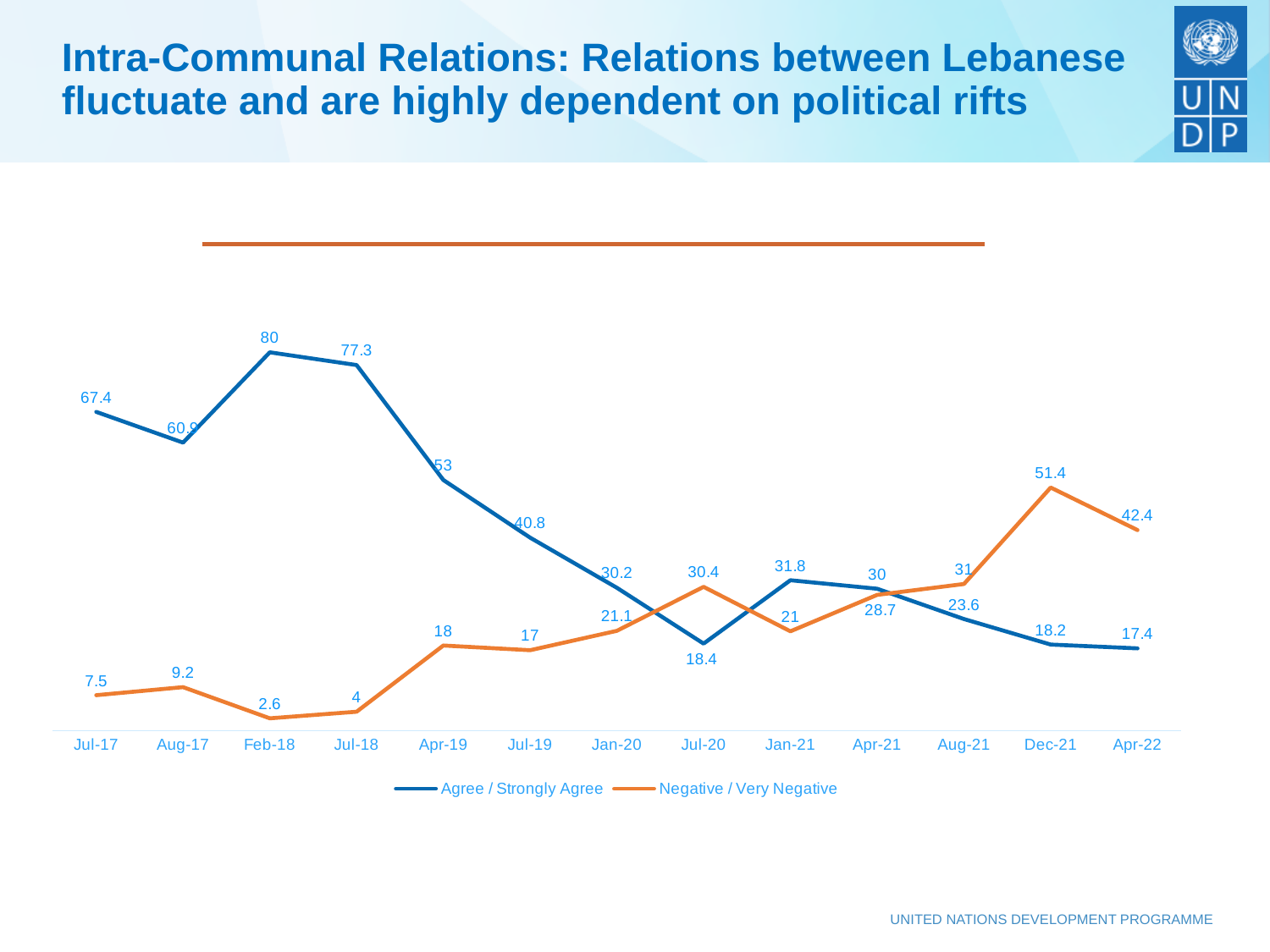
How many series does the legend list? 2 What is the value for Agree / Strongly Agree in Apr-22? 17.4 What colour is the line for Negative / Very Negative? orange In which period is the Agree / Strongly Agree series at its highest? Feb-18 Does the Negative / Very Negative series generally rise or fall from Jul-17 to Apr-22? rise How many time points are shown on the x axis? 13 What is the value for Agree / Strongly Agree in Feb-18? 80 What kind of chart is shown on the slide? line chart What is the value for Negative / Very Negative in Dec-21? 51.4 What is the difference between the Agree / Strongly Agree value in Jul-18 and in Apr-19? 24.3 In which period is the Negative / Very Negative series at its lowest? Feb-18 In Jul-20, which series has the larger value, Agree / Strongly Agree or Negative / Very Negative? Negative / Very Negative